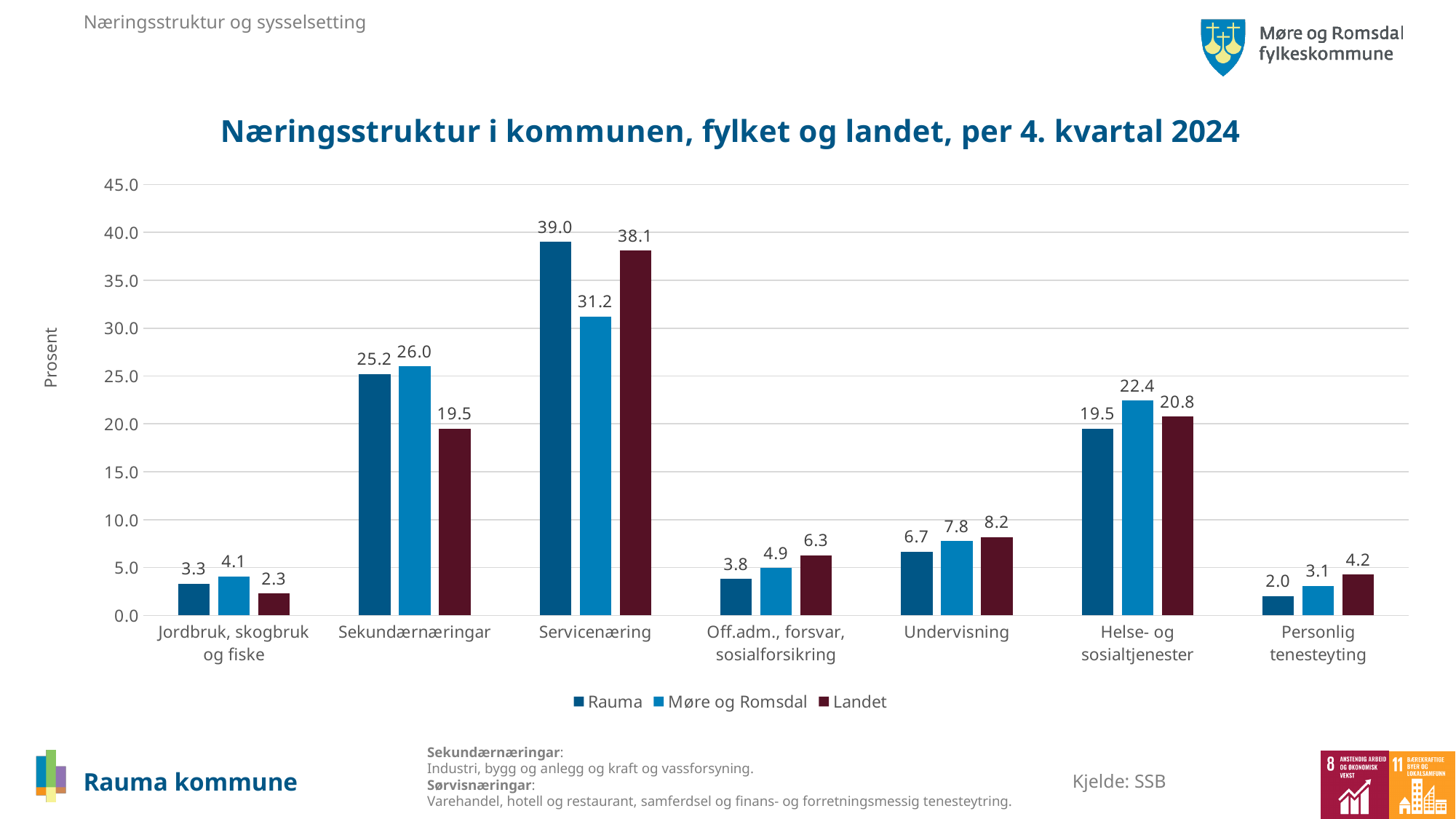
How many series does the legend list? 3 How many categories are shown on the x axis? 7 What is the value for Rauma in the Servicenæring category? 39.0 What is the difference between the Rauma and Møre og Romsdal values in the Servicenæring category? 7.8 Which is larger in the Undervisning category: the value for Rauma or the value for Landet? Landet What kind of chart is shown on the slide? Bar chart Is the value for Landet in the Servicenæring category greater or less than 35.0? greater What is the value for Møre og Romsdal in the Helse- og sosialtjenester category? 22.4 What is the value for Landet in the Sekundærnæringar category? 19.5 Which category has the lowest value for Landet? Jordbruk, skogbruk og fiske Which category has the highest value for Rauma? Servicenæring What is the title of the chart? Næringsstruktur i kommunen, fylket og landet, per 4. kvartal 2024